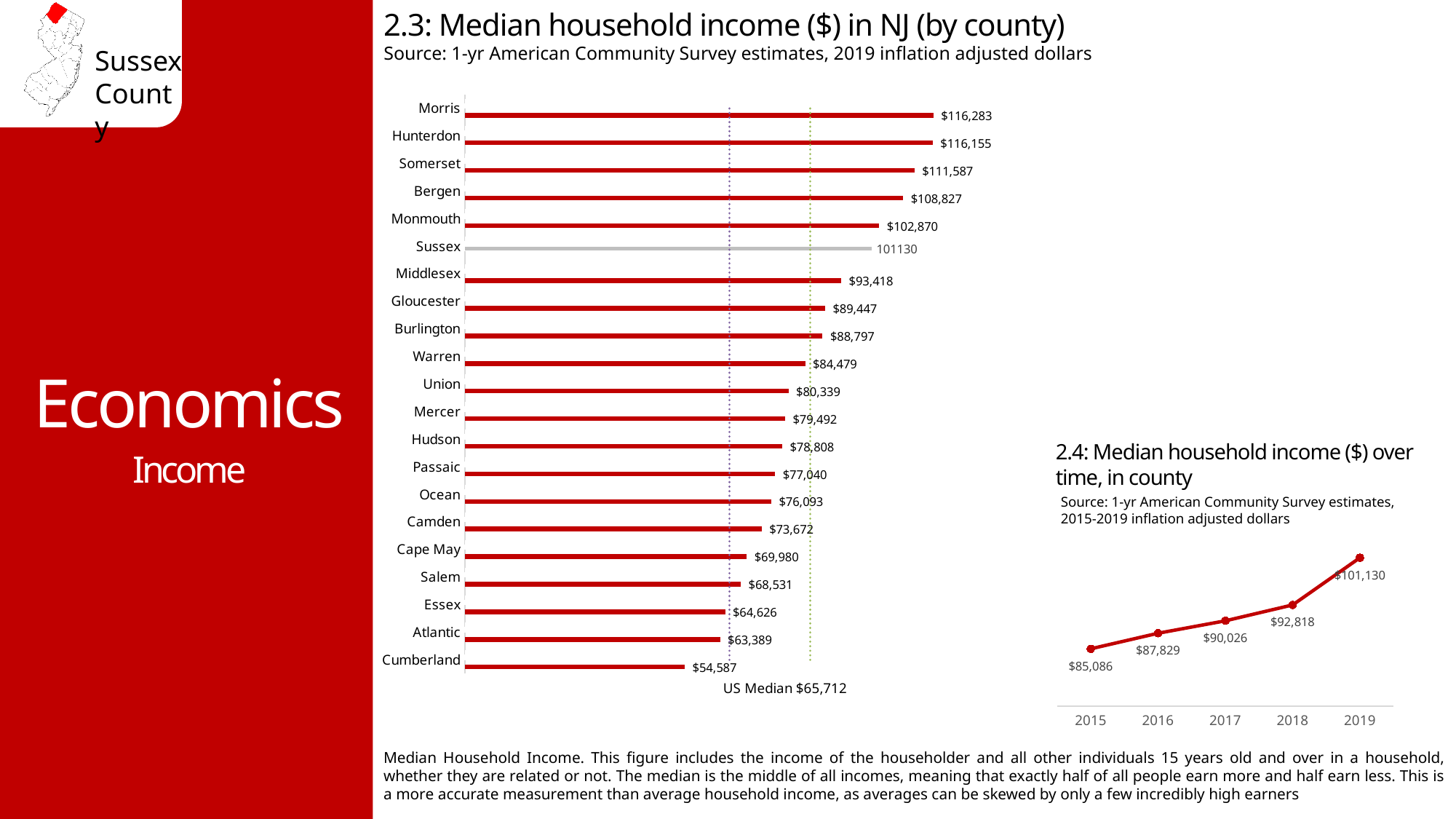
In chart 2.4 (Median household income over time, in county), does the median household income rise or fall from 2015 to 2019? Rise In chart 2.3 (Median household income by county), what is the median household income for Cumberland? $54,587 In chart 2.3 (Median household income by county), what is the difference between the median household income of Bergen and Monmouth? $5,957 In chart 2.3 (Median household income by county), how many counties are plotted? 21 In chart 2.4 (Median household income over time, in county), what is the difference between the 2019 and 2018 values? $8,312 In chart 2.3 (Median household income by county), which has a higher median household income, Gloucester or Burlington? Gloucester In chart 2.4 (Median household income over time, in county), what is the median household income for 2017? $90,026 In chart 2.3 (Median household income by county), which county has the lowest median household income? Cumberland In chart 2.3 (Median household income by county), what US Median value is noted on the chart? $65,712 In chart 2.3 (Median household income by county), what is the median household income for Morris? $116,283 What kind of chart is chart 2.3 (Median household income by county)? Bar chart In chart 2.3 (Median household income by county), which county has the highest median household income? Morris